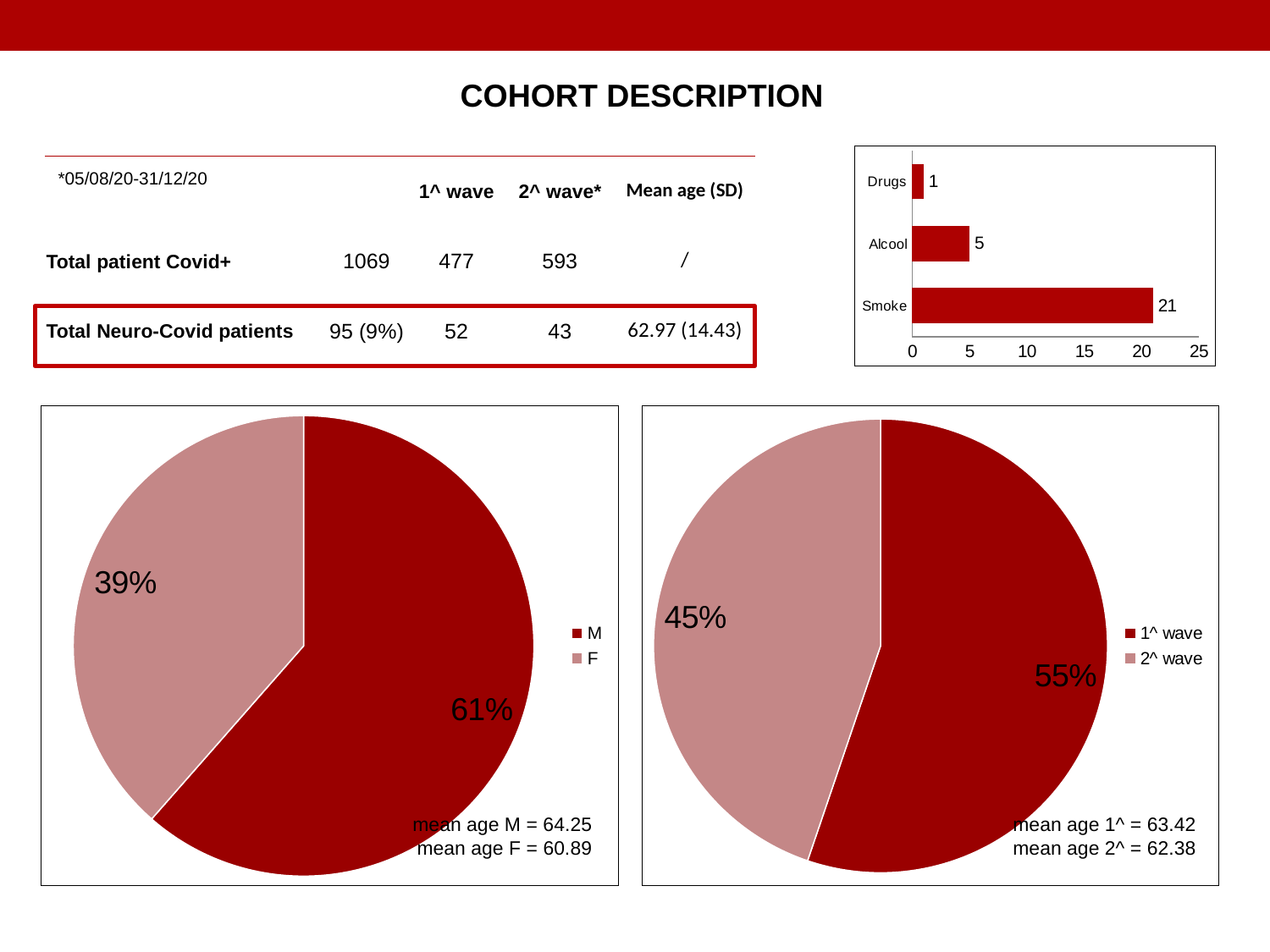
In the bar chart at the top right, what is the value for Smoke? 21 What kind of chart is shown at the top right of the slide? Bar chart In the pie chart at the bottom right, how many entries does the legend list? 2 In the bar chart at the top right, which category has the highest value? Smoke In the bar chart at the top right, what is the value for Alcool? 5 In the bar chart at the top right, which category has the lowest value? Drugs In the bar chart at the top right, how many categories are shown? 3 In the pie chart at the bottom left, what share does M have? 61% In the bar chart at the top right, what is the value for Drugs? 1 In the pie chart at the bottom right, what share does 2^ wave have? 45% In the bar chart at the top right, what is the difference between the values for Smoke and Alcool? 16 In the pie chart at the bottom left, which is larger, M or F? M